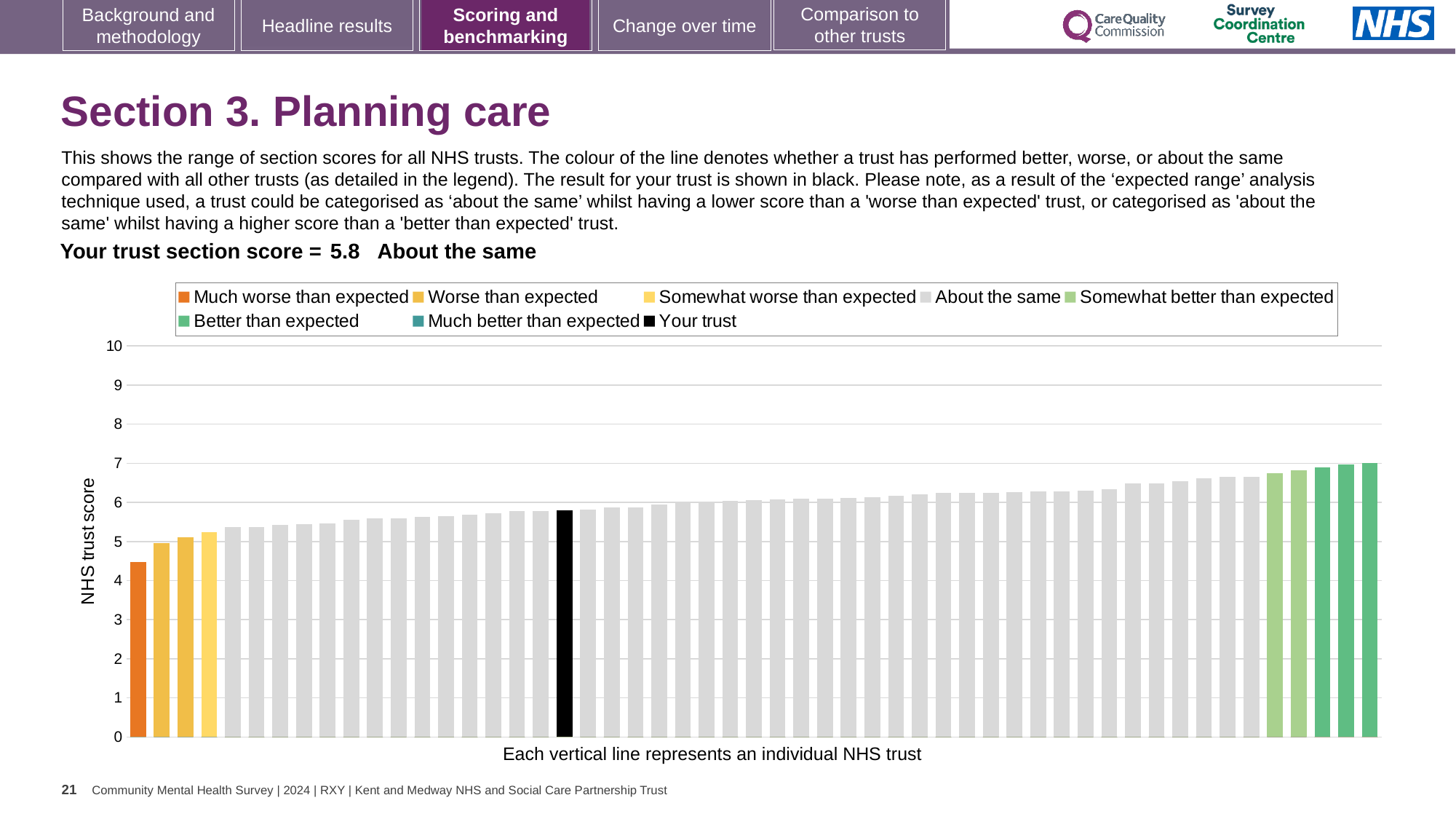
How is your trust's section score categorised compared with other trusts? About the same What is the label on the vertical axis of the chart? NHS trust score How many entries does the chart legend list? 8 Which colour of bar is the lowest on the chart? orange (Much worse than expected) Is the value for the black 'Your trust' bar greater or less than 5? greater What kind of chart is shown on the slide? bar chart What is the section score for your trust shown on the slide? 5.8 Do the bar values rise or fall from left to right along the x axis? rise Which is larger: the black 'Your trust' bar or the orange 'Much worse than expected' bar? Your trust Is the value of the tallest bar greater or less than 6? greater According to the x-axis caption, what does each vertical line represent? an individual NHS trust Is the value for the orange 'Much worse than expected' bar greater or less than 5? less